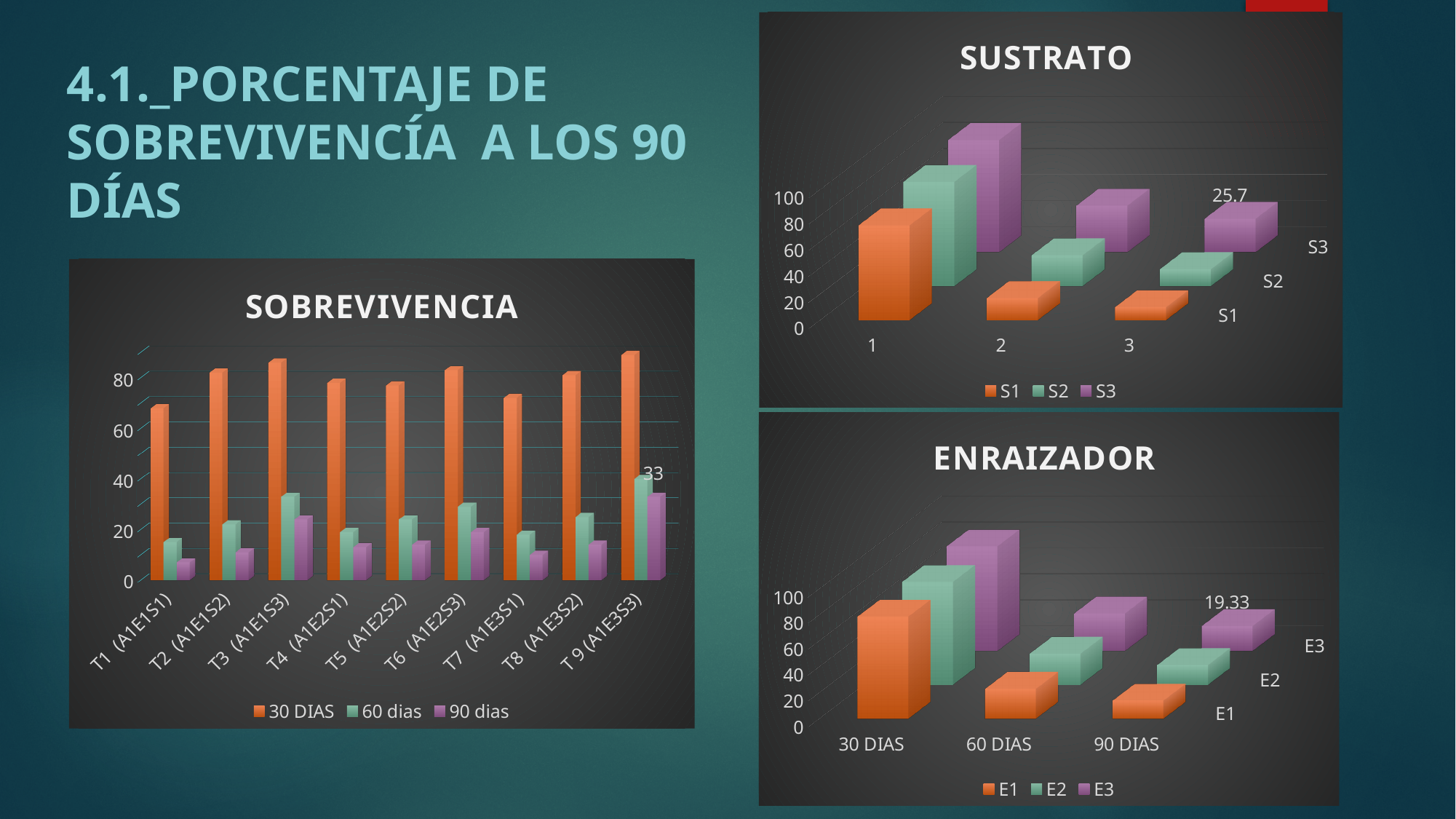
What are the legend entries of the SOBREVIVENCIA chart? 30 DIAS, 60 dias, 90 dias How many categories are shown on the x axis of the SOBREVIVENCIA chart? 9 In the SOBREVIVENCIA chart, which series has the tallest bar in every category? 30 DIAS In the SOBREVIVENCIA chart, is the 30 DIAS value for T1 (A1E1S1) greater or less than 40? greater In the SUSTRATO chart, at category 1, which is larger: S1 or S3? S3 How many series does the legend of the SOBREVIVENCIA chart list? 3 In the SUSTRATO chart, what value is labelled for S3 at category 3? 25.7 In the SOBREVIVENCIA chart, is the 90 dias value for T1 (A1E1S1) greater or less than 20? less In the SUSTRATO chart, do the S1 values rise or fall from category 1 to category 3? fall What kind of chart is the SOBREVIVENCIA chart? bar chart How many series does the legend of the SUSTRATO chart list? 3 In the ENRAIZADOR chart, what value is labelled for E3 at 90 DIAS? 19.33